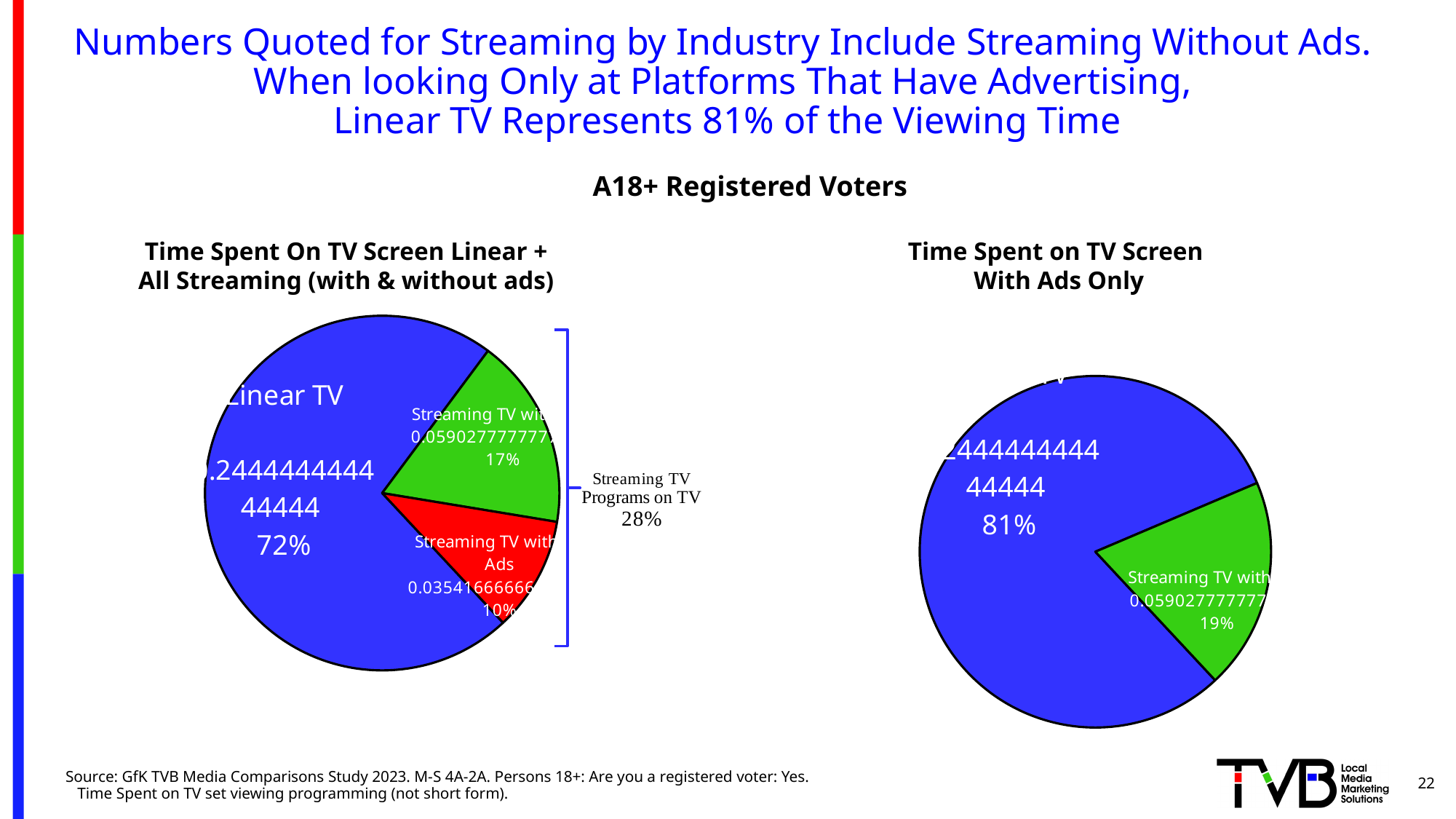
In the left chart, 'Time Spent On TV Screen Linear + All Streaming (with & without ads)', what percentage is shown for the green slice? 17% In the right chart, 'Time Spent on TV Screen With Ads Only', what is the difference in percentage points between the blue slice (81%) and the green slice (19%)? 62 percentage points In the left chart, 'Time Spent On TV Screen Linear + All Streaming (with & without ads)', which slice is the smallest? Streaming TV with Ads In the right chart, 'Time Spent on TV Screen With Ads Only', what share of viewing time does the blue Linear TV slice represent? 81% In the right chart, 'Time Spent on TV Screen With Ads Only', what percentage is shown for the green streaming slice? 19% In the left chart, how many slices does the pie have? 3 What type of chart is used on the right side of the slide, 'Time Spent on TV Screen With Ads Only'? Pie chart In the left chart, 'Time Spent On TV Screen Linear + All Streaming (with & without ads)', what percentage is shown for the red 'Streaming TV with Ads' slice? 10% In the left chart, what combined percentage is shown by the bracket for 'Streaming TV Programs on TV'? 28% In the left chart, 'Time Spent On TV Screen Linear + All Streaming (with & without ads)', what share of viewing time does Linear TV represent? 72% Which is larger: the Linear TV share in the left chart (72%) or the Linear TV share in the right chart (81%)? The right chart (81%) In the left chart, 'Time Spent On TV Screen Linear + All Streaming (with & without ads)', which slice is the largest? Linear TV